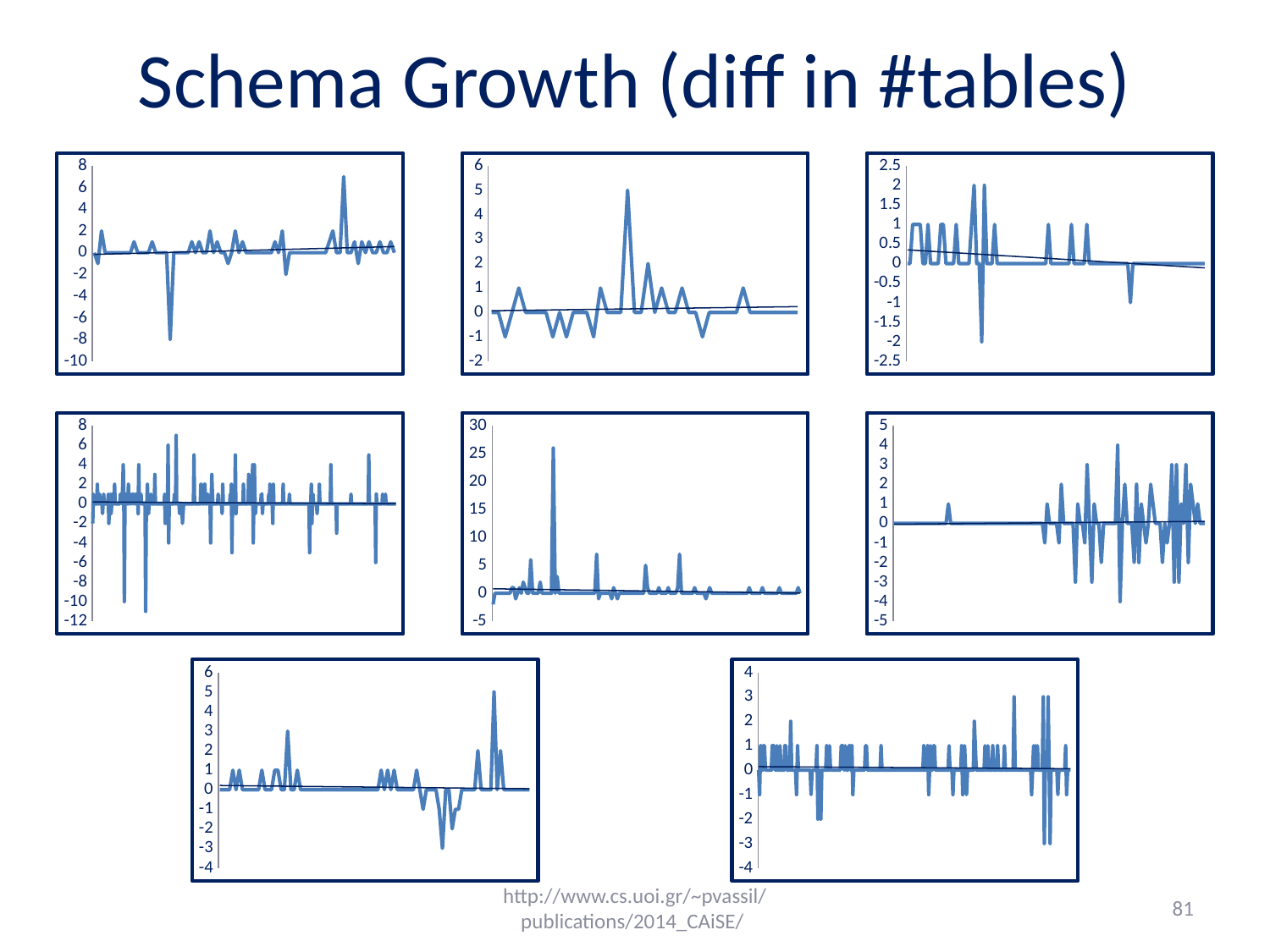
In the top-middle chart, is the highest peak greater or less than 4? greater In the top-right chart, is the highest peak greater or less than 1.5? greater In the right chart of the middle row, is the highest peak greater or less than 3? greater What is the maximum value shown on the vertical axis of the middle chart in the middle row? 30 How many charts are shown on the slide? 8 In the top-right chart, does the thin trend line rise or fall from left to right? fall What kind of chart is the top-left chart on the slide? line chart